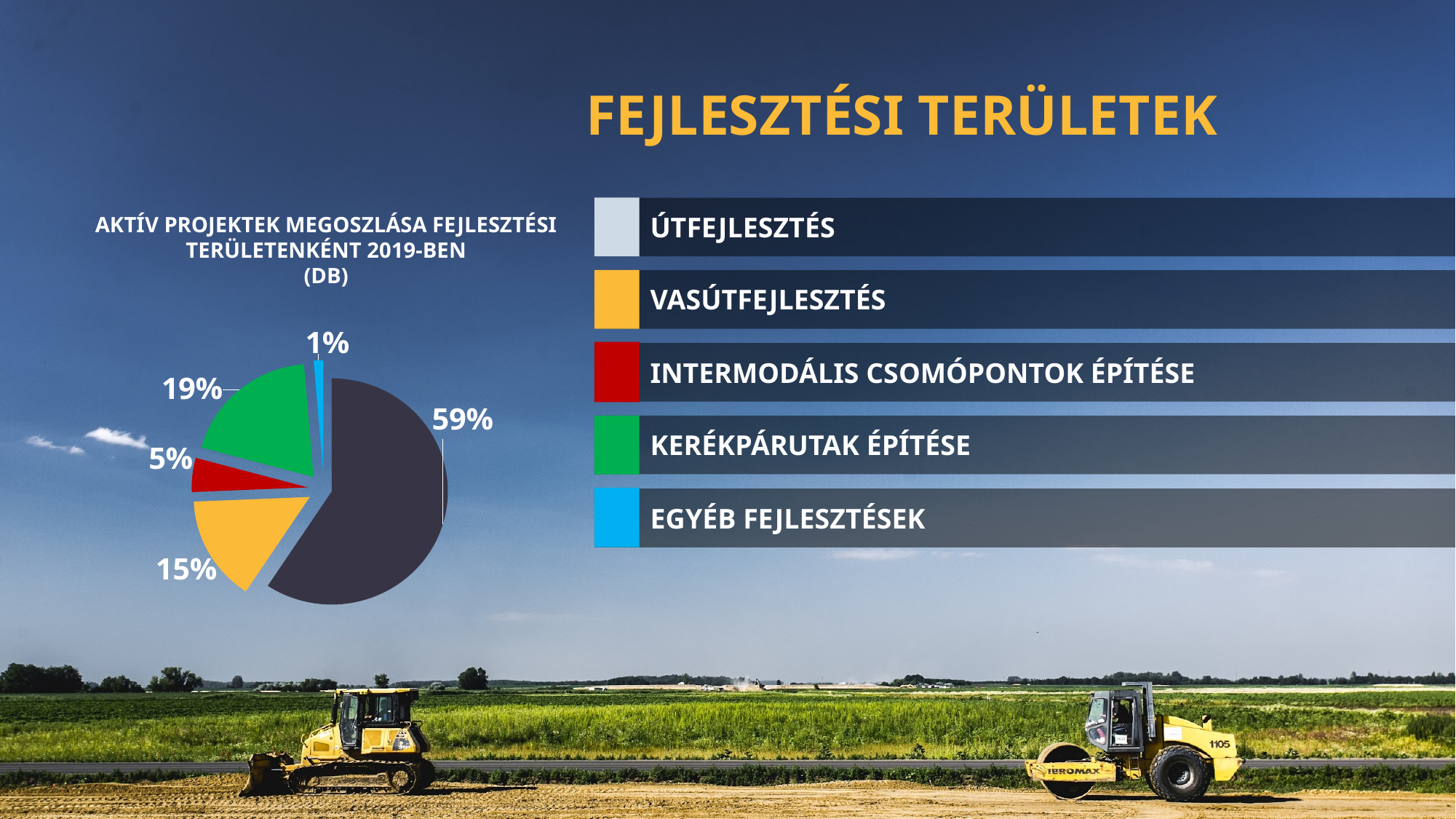
How many development areas are listed in the legend on the right? 5 What share of the pie does the light blue slice (Egyéb fejlesztések) represent? 1% What is the share of the largest slice of the pie chart? 59% What share of the pie does the green slice (Kerékpárutak építése) represent? 19% Which is larger: the green slice (Kerékpárutak építése) or the orange slice (Vasútfejlesztés)? Kerékpárutak építése What share of the pie does the red slice (Intermodális csomópontok építése) represent? 5% What is the title of the pie chart? AKTÍV PROJEKTEK MEGOSZLÁSA FEJLESZTÉSI TERÜLETENKÉNT 2019-BEN (DB) What kind of chart is shown on the slide? pie chart What is the difference in percentage points between the largest slice (59%) and the green slice (19%)? 40 How many slices does the pie chart have? 5 What is the share of the smallest slice of the pie chart? 1%